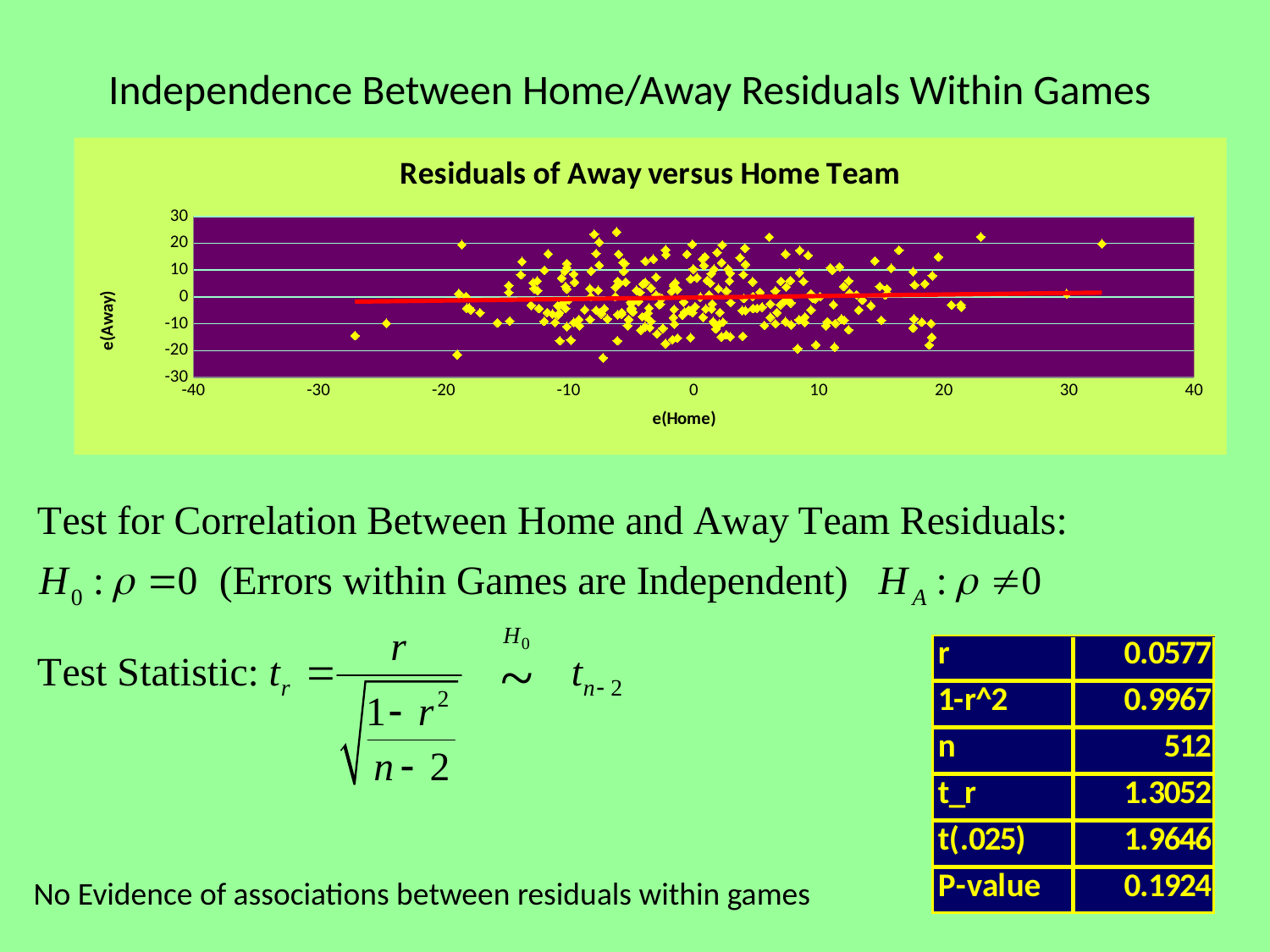
What is the title of the chart? Residuals of Away versus Home Team What is the minimum value shown on the horizontal axis of the chart? -40 What kind of chart is shown on the slide? scatter chart What is the label on the horizontal axis of the chart? e(Home) What is the label on the vertical axis of the chart? e(Away) Does the fitted trend line in the chart show a strong rise, a strong fall, or stay nearly flat as e(Home) increases? nearly flat What is the maximum value shown on the horizontal axis of the chart? 40 What is the spacing between consecutive tick marks on the horizontal axis of the chart? 10 What is the maximum value shown on the vertical axis of the chart? 30 Are all the plotted points in the chart above or below the 30 line on the vertical axis? below What is the minimum value shown on the vertical axis of the chart? -30